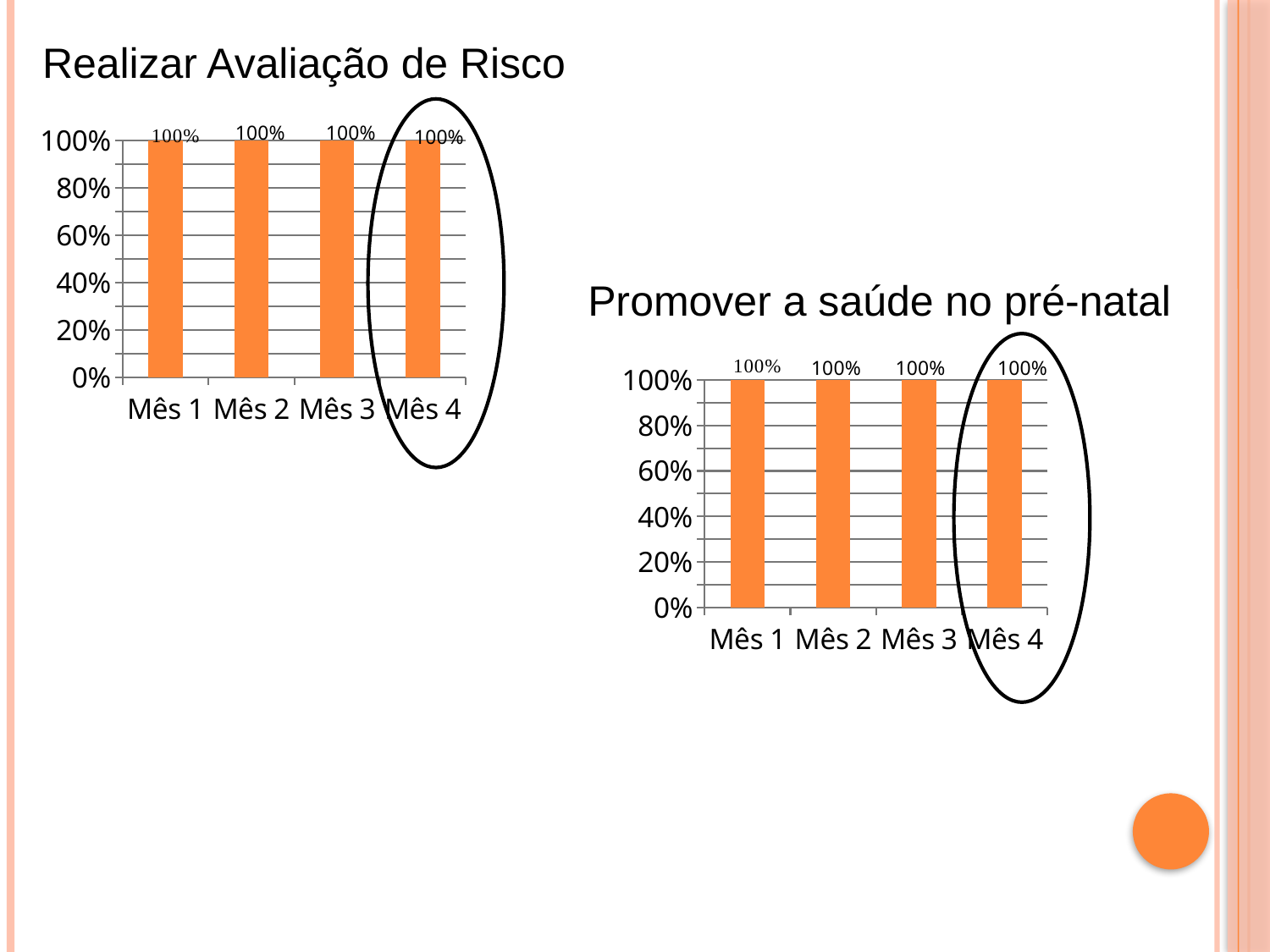
In the 'Promover a saúde no pré-natal' chart, what is the difference between the values for Mês 2 and Mês 4? 0% In the 'Promover a saúde no pré-natal' chart, do the values rise, fall or stay the same from Mês 1 to Mês 4? Stay the same In the 'Realizar Avaliação de Risco' chart, what is the value for Mês 1? 100% What kind of chart is the 'Realizar Avaliação de Risco' chart? Bar chart What is the title of the chart on the right side of the slide? Promover a saúde no pré-natal In the 'Promover a saúde no pré-natal' chart, what is the value for Mês 2? 100% How many categories are shown in the 'Promover a saúde no pré-natal' chart? 4 In the 'Realizar Avaliação de Risco' chart, what is the value for Mês 4? 100% In the 'Promover a saúde no pré-natal' chart, what is the value for Mês 4? 100% In the 'Realizar Avaliação de Risco' chart, is the value for Mês 2 greater or less than 80%? greater In the 'Realizar Avaliação de Risco' chart, what is the difference between the values for Mês 1 and Mês 3? 0% How many categories are shown in the 'Realizar Avaliação de Risco' chart? 4